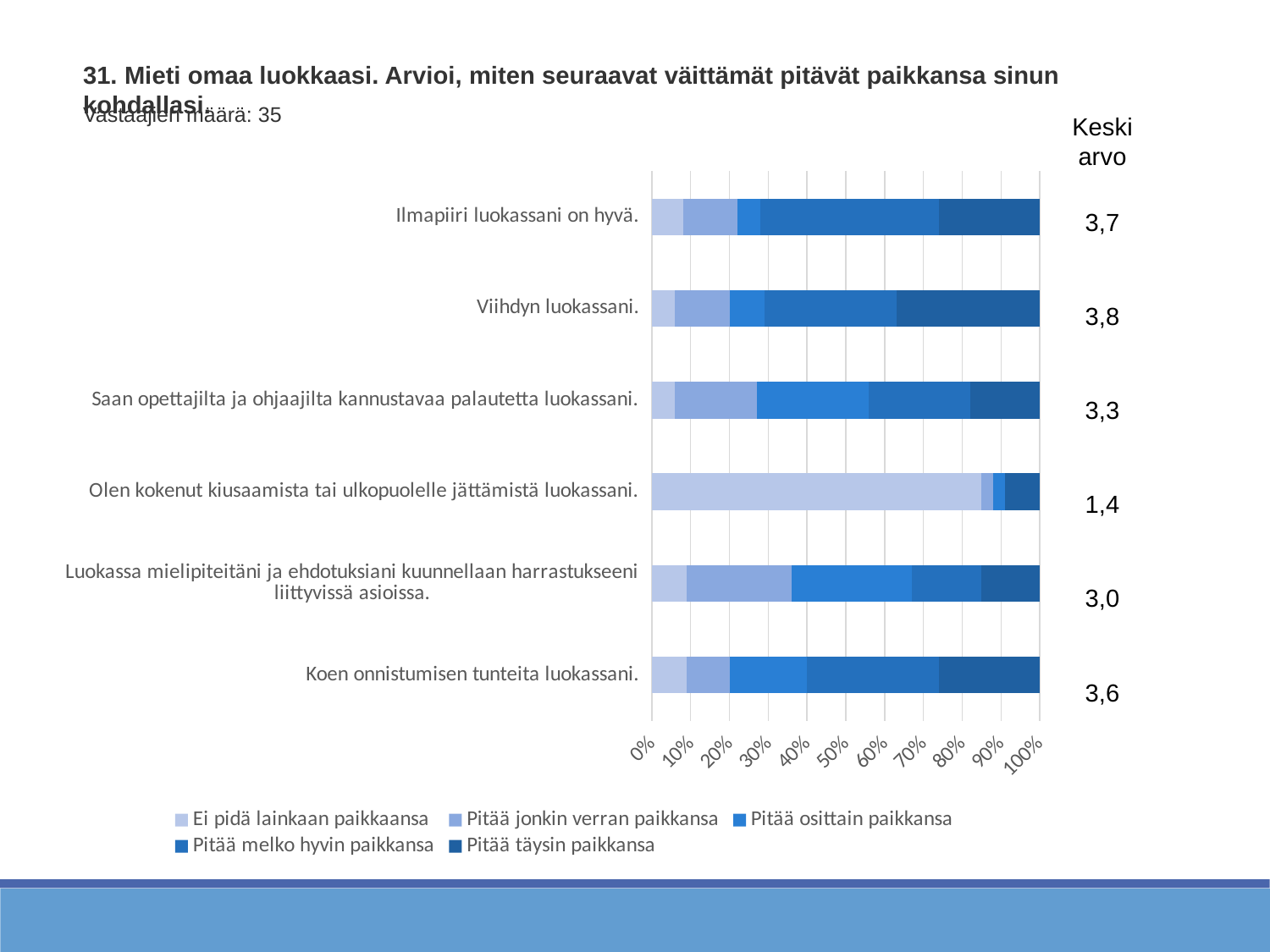
What is the Keskiarvo value shown for "Koen onnistumisen tunteita luokassani."? 3,6 What is the difference between the Keskiarvo values of "Viihdyn luokassani." and "Olen kokenut kiusaamista tai ulkopuolelle jättämistä luokassani."? 2,4 Which has a higher Keskiarvo value: "Saan opettajilta ja ohjaajilta kannustavaa palautetta luokassani." or "Luokassa mielipiteitäni ja ehdotuksiani kuunnellaan harrastukseeni liittyvissä asioissa."? Saan opettajilta ja ohjaajilta kannustavaa palautetta luokassani. What is the Keskiarvo (mean) value shown for "Ilmapiiri luokassani on hyvä."? 3,7 What is the Keskiarvo value shown for "Olen kokenut kiusaamista tai ulkopuolelle jättämistä luokassani."? 1,4 How many respondents (Vastaajien määrä) does the slide report? 35 How many series does the legend list? 5 Which statement has the lowest Keskiarvo value? Olen kokenut kiusaamista tai ulkopuolelle jättämistä luokassani. How many statements (categories) are plotted in the chart? 6 What kind of chart is shown on the slide? Stacked bar chart Is the "Ei pidä lainkaan paikkaansa" share for "Olen kokenut kiusaamista tai ulkopuolelle jättämistä luokassani." greater or less than 80%? greater Which statement has the highest Keskiarvo value? Viihdyn luokassani.